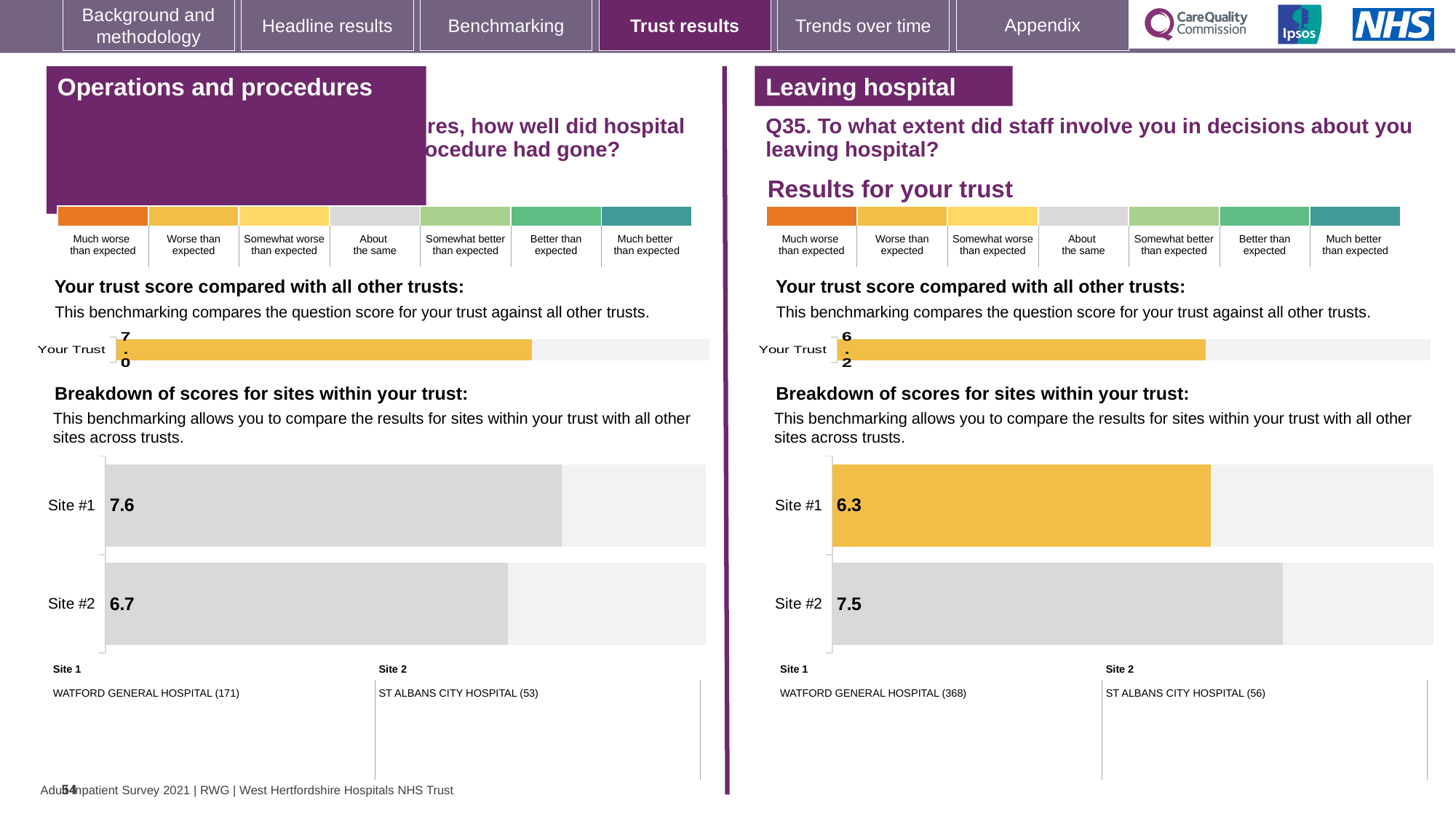
In the 'Leaving hospital' site breakdown chart on the right, what is the score for Site #1? 6.3 In the 'Operations and procedures' trust score chart on the left, what is the score for Your Trust? 7.0 In the 'Operations and procedures' site breakdown chart on the left, what is the score for Site #1? 7.6 What type of chart is used for the site breakdown of scores on the left side of the slide? Bar chart In the 'Leaving hospital' site breakdown chart on the right, what is the score for Site #2? 7.5 In the 'Leaving hospital' trust score chart on the right, what is the score for Your Trust? 6.2 In the 'Leaving hospital' site breakdown chart on the right, what is the difference between the Site #2 and Site #1 scores? 1.2 In the 'Operations and procedures' site breakdown chart on the left, what is the difference between the Site #1 and Site #2 scores? 0.9 In the 'Operations and procedures' site breakdown chart on the left, which site has the higher score? Site #1 How many sites are shown in the 'Leaving hospital' site breakdown chart on the right? 2 In the 'Operations and procedures' site breakdown chart on the left, what is the score for Site #2? 6.7 In the 'Leaving hospital' site breakdown chart on the right, which site has the lower score? Site #1